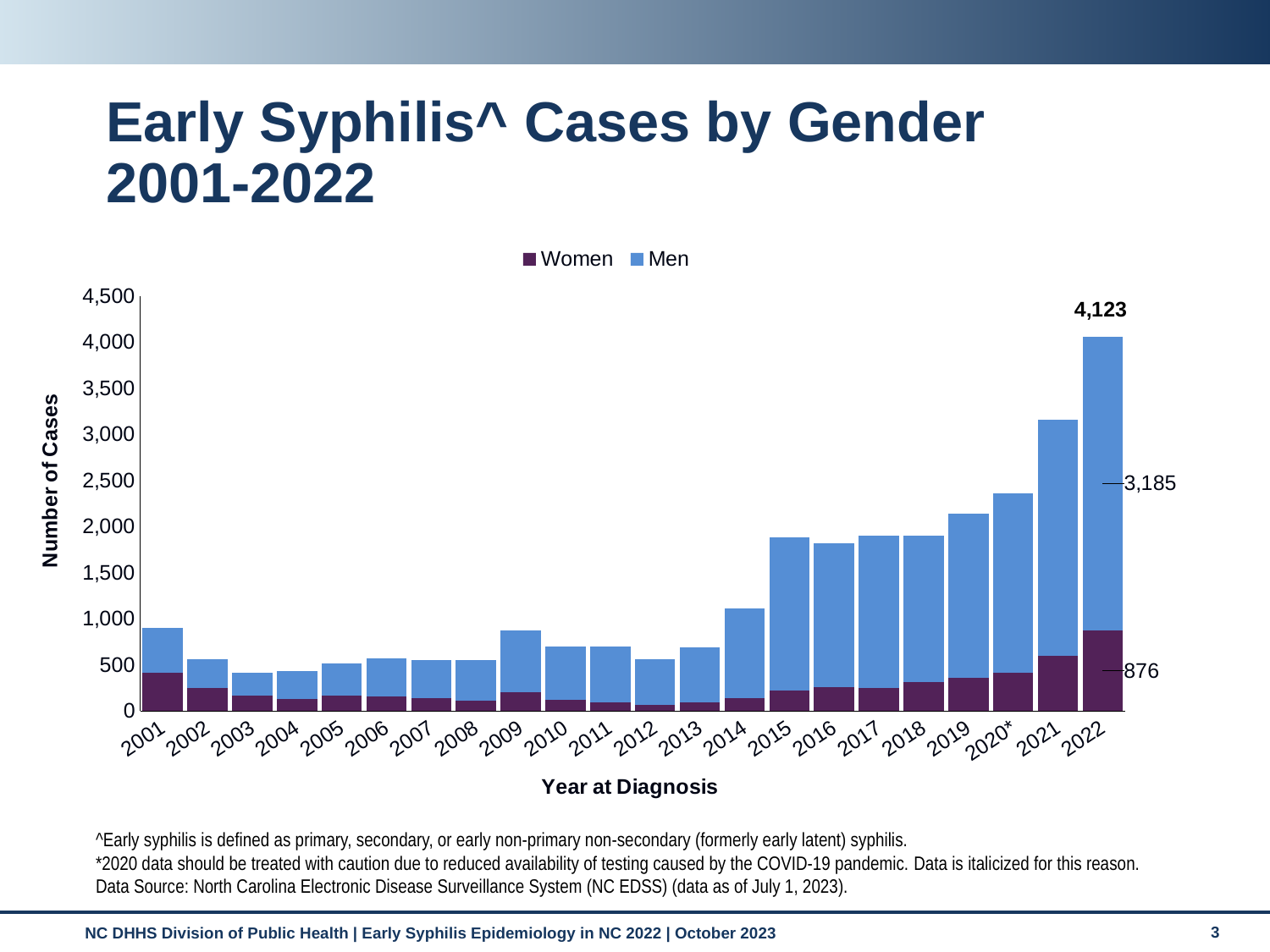
How many series does the legend list? 2 What is the difference between the number of cases among men and among women in 2022? 2,309 Is the total number of cases in 2021 greater or less than 3,000? greater How many early syphilis cases among women were diagnosed in 2022? 876 What is the total number of early syphilis cases shown for 2022? 4,123 Which year has the highest total number of early syphilis cases? 2022 How many years are shown on the x axis? 22 How many early syphilis cases among men were diagnosed in 2022? 3,185 What kind of chart is shown on the slide? Stacked bar chart What is the title of the x axis? Year at Diagnosis Is the total number of cases in 2003 greater or less than 500? less In 2022, were there more cases among men or among women? Men